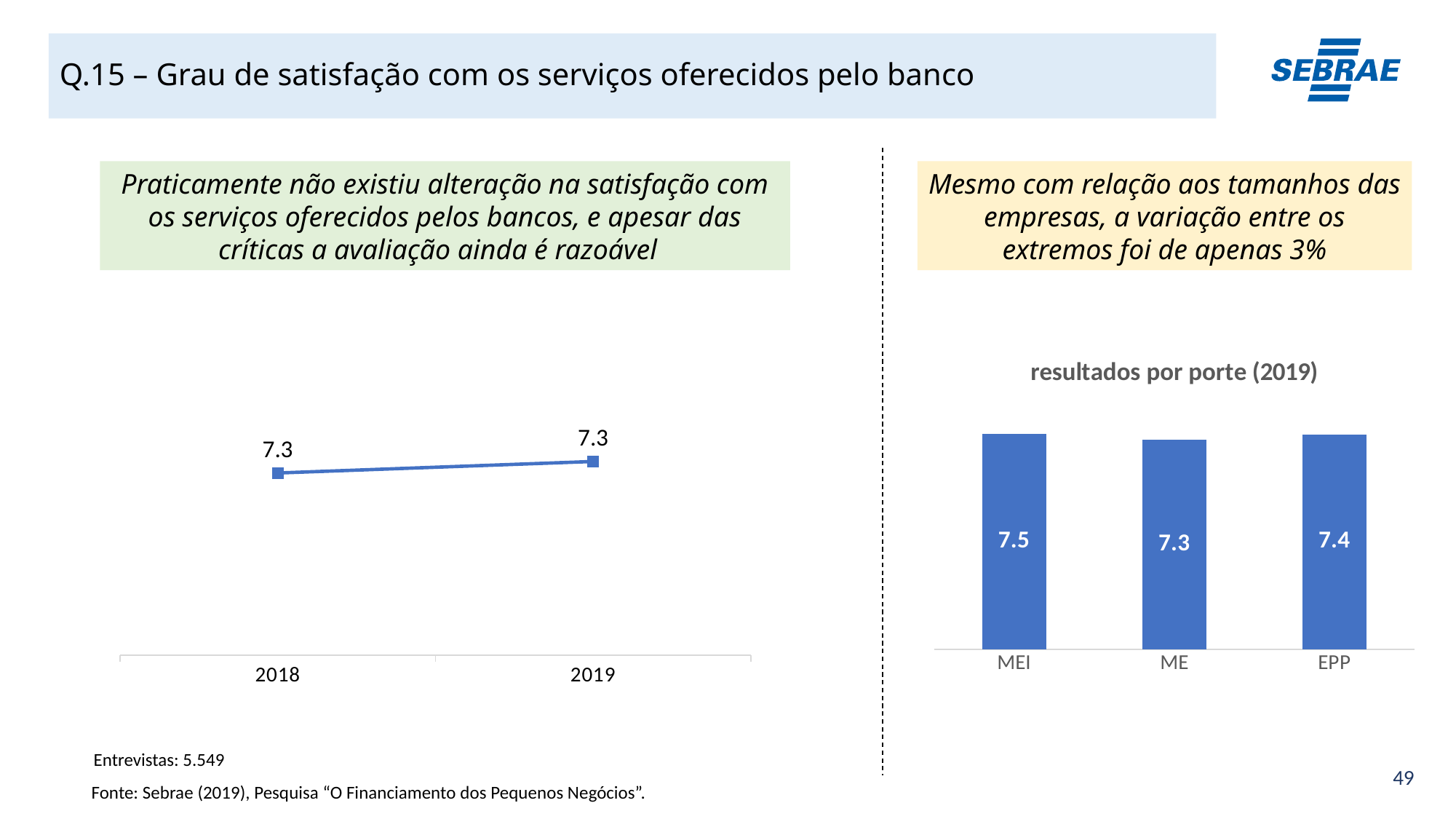
In the chart titled 'resultados por porte (2019)', which category has the highest value? MEI In the chart titled 'resultados por porte (2019)', what is the difference between the values for MEI and ME? 0.2 How many data points are plotted in the chart on the left? 2 In the chart titled 'resultados por porte (2019)', what is the value for MEI? 7.5 What kind of chart is the chart titled 'resultados por porte (2019)'? bar chart What kind of chart is the chart on the left? line chart In the chart on the left, what is the value for 2019? 7.3 In the chart on the left, what is the value for 2018? 7.3 In the chart titled 'resultados por porte (2019)', what is the value for EPP? 7.4 How many categories are shown in the chart titled 'resultados por porte (2019)'? 3 In the chart titled 'resultados por porte (2019)', what is the value for ME? 7.3 In the chart titled 'resultados por porte (2019)', which category has the lowest value? ME